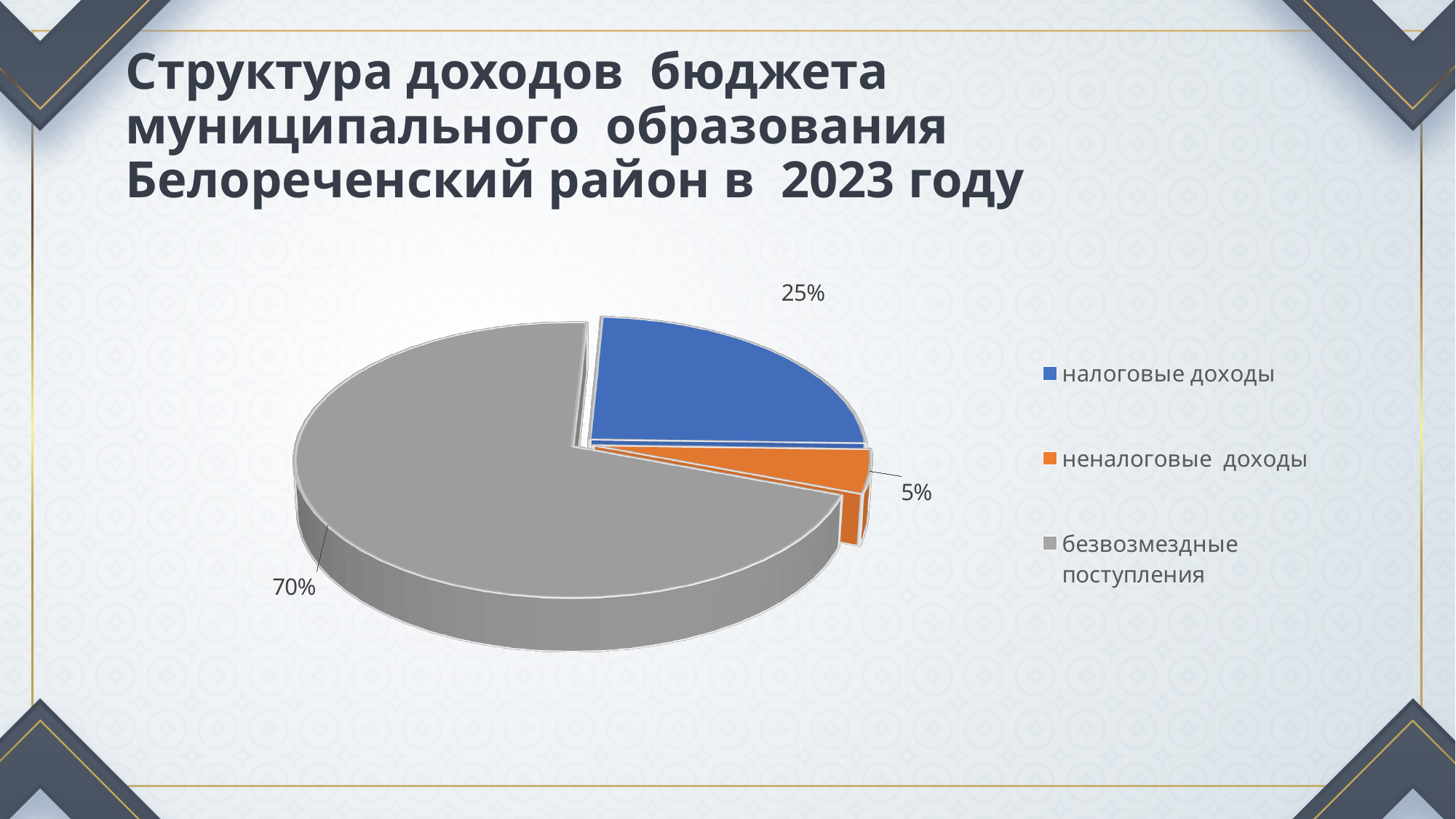
Which category has the smallest share of the pie? неналоговые доходы What is the difference in percentage points between безвозмездные поступления and налоговые доходы? 45 What colour is the slice for безвозмездные поступления? grey What kind of chart is shown on the slide? pie chart What share of the pie does налоговые доходы have? 25% What share of the pie does неналоговые доходы have? 5% How many entries does the legend list? 3 How many slices does the pie chart have? 3 Which category has the largest share of the pie? безвозмездные поступления Which is larger, the share for налоговые доходы or the share for неналоговые доходы? налоговые доходы What share of the pie does безвозмездные поступления have? 70% What is the difference in percentage points between налоговые доходы and неналоговые доходы? 20